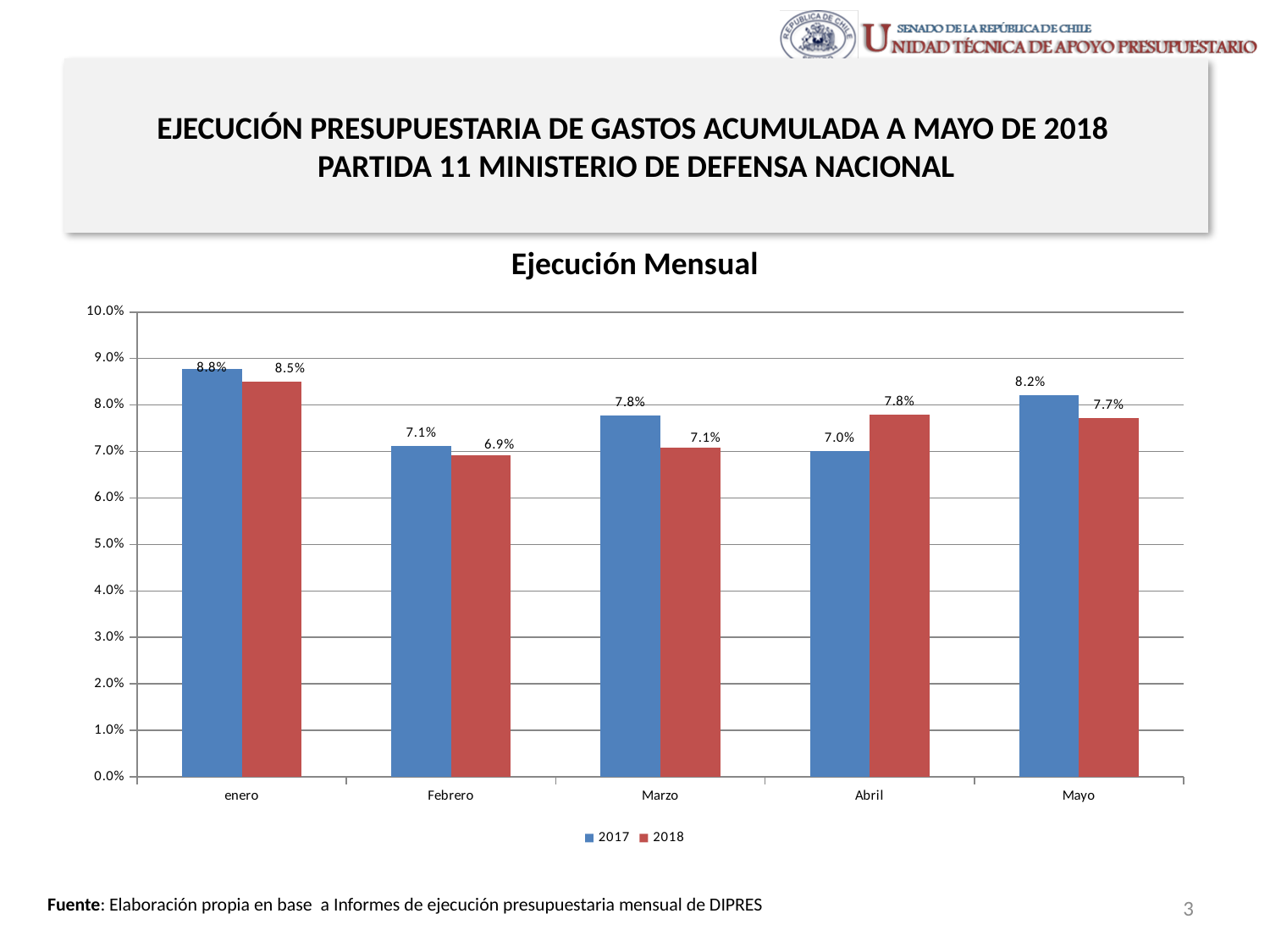
Does the 2018 series rise or fall from Febrero to Abril? rise How many months are shown on the x axis? 5 Is the value for 2017 in Mayo greater or less than 8.0%? greater In Abril, which series has the larger value, 2017 or 2018? 2018 What is the value for 2018 in Mayo? 7.7% Which month has the highest value for the 2017 series? enero What kind of chart is shown on the slide? bar chart How many series does the legend list? 2 What is the difference between the 2017 and 2018 values in Marzo? 0.7 percentage points Which month has the lowest value for the 2018 series? Febrero What is the value for 2018 in Abril? 7.8% What is the value for 2017 in enero? 8.8%